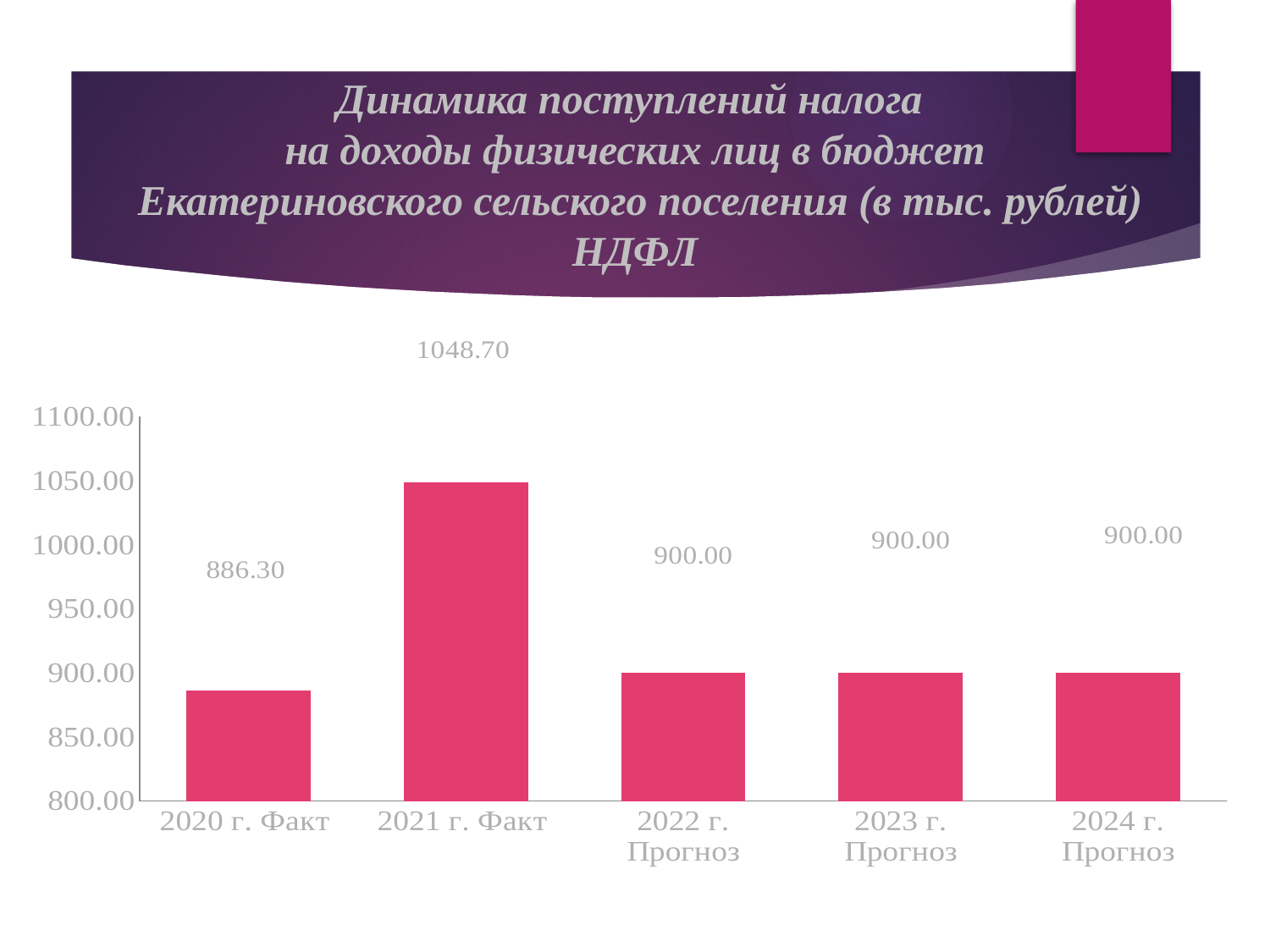
What is the value for 2021 г. Факт? 1048.70 What is the difference between the values for 2021 г. Факт and 2022 г. Прогноз? 148.70 What is the value at which the vertical axis starts? 800.00 Which category has the highest value? 2021 г. Факт Which category has the lowest value? 2020 г. Факт What is the difference between the values for 2021 г. Факт and 2020 г. Факт? 162.40 Is the value for 2021 г. Факт greater or less than 1000.00? greater What kind of chart is shown on the slide? bar chart What is the value for 2023 г. Прогноз? 900.00 How many categories are shown on the x axis? 5 Which is larger, the value for 2020 г. Факт or the value for 2022 г. Прогноз? 2022 г. Прогноз What is the value for 2020 г. Факт? 886.30